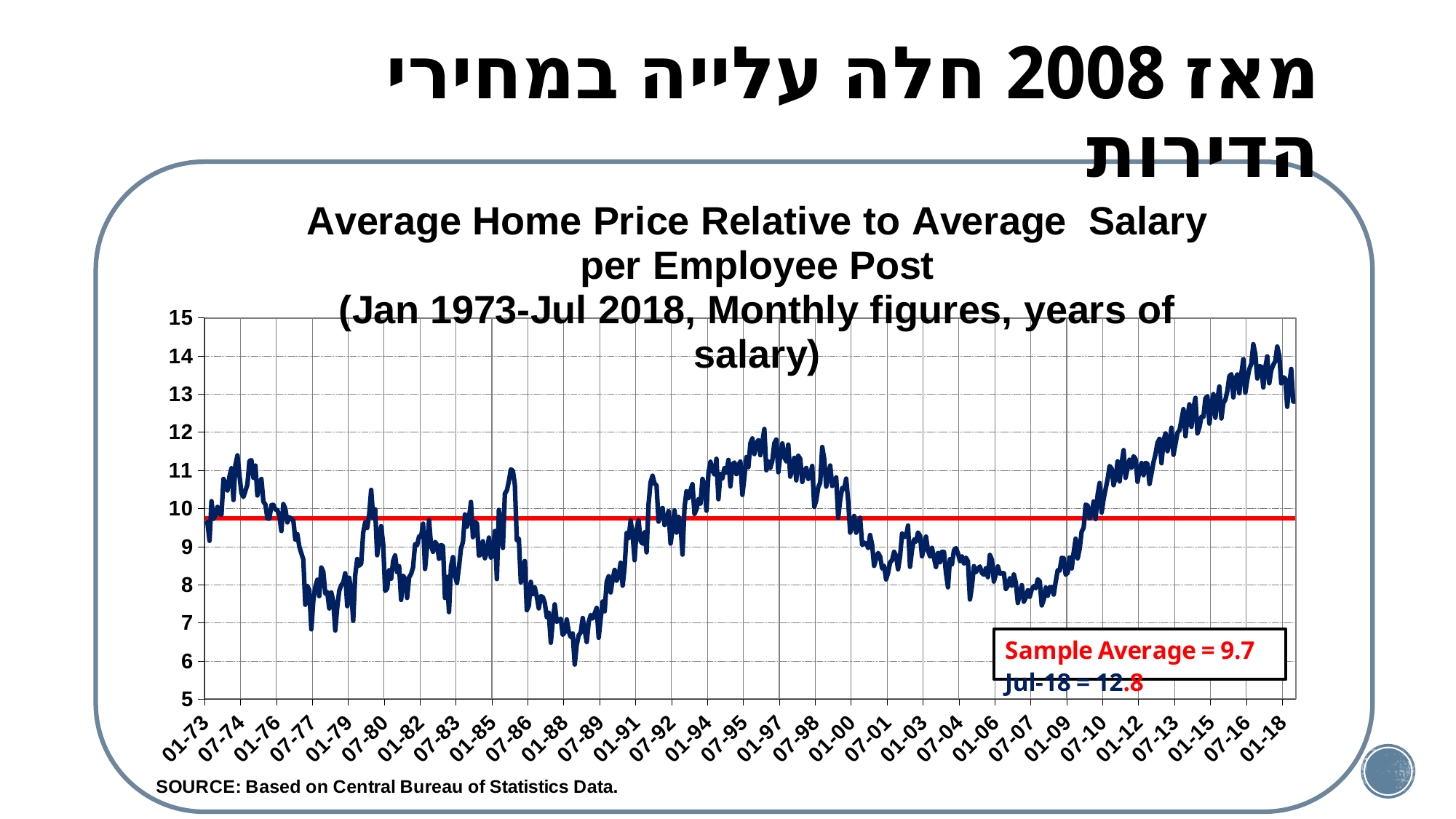
What is the value for Jul-18 according to the annotation on the chart? 12.8 Is the value around 07-07 greater or less than 9? less What is the highest value shown on the vertical axis? 15 What kind of chart is shown on the slide? line chart What does the red horizontal line on the chart represent? Sample Average = 9.7 Is the value around 07-16 greater or less than 13? greater Is the value around 01-97 greater or less than 10? greater What is the sample average shown on the chart? 9.7 Does the series rise or fall between 01-09 and 07-16? rise By how much does the Jul-18 value exceed the sample average? 3.1 Which is larger, the Jul-18 value or the sample average? Jul-18